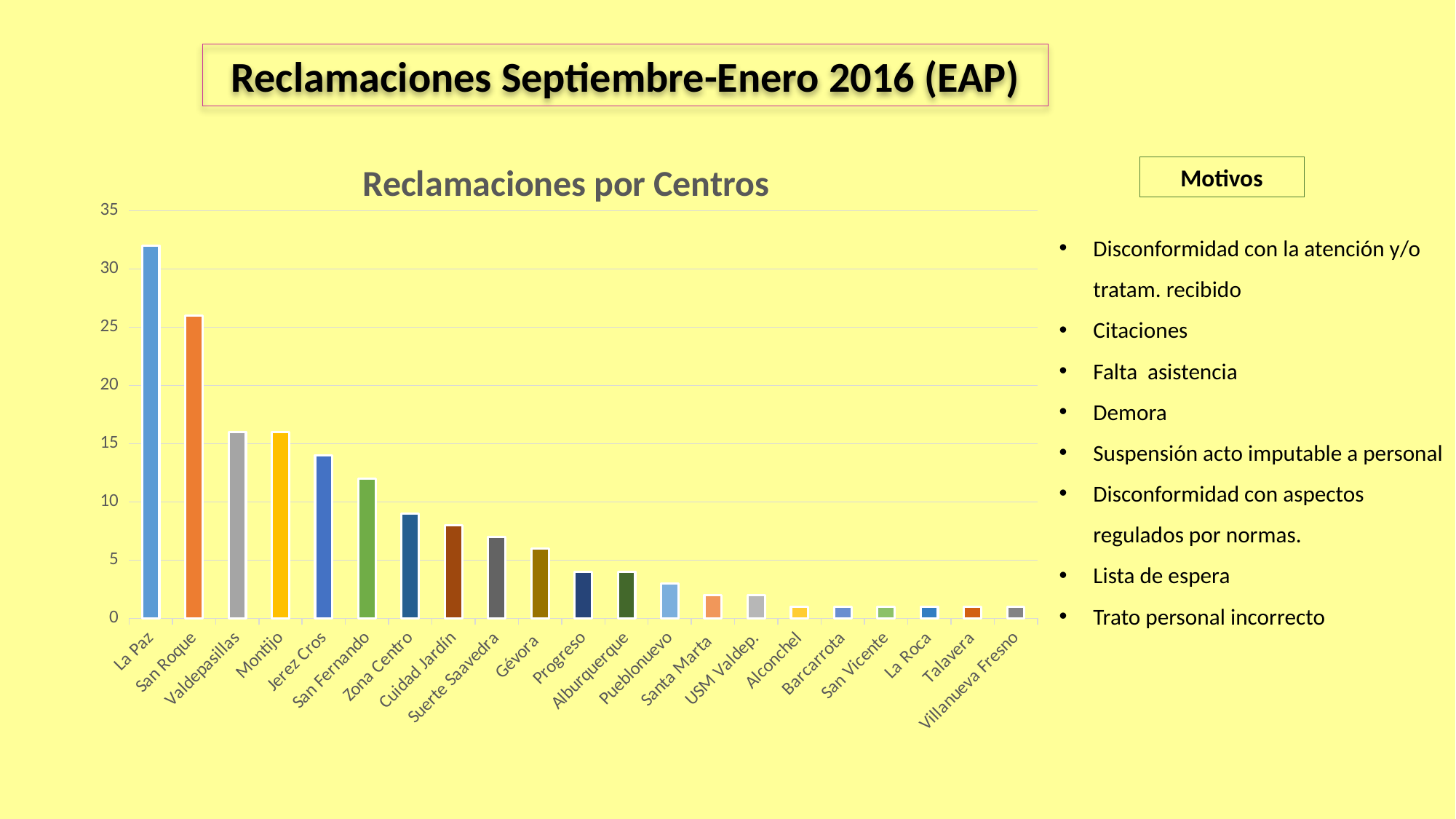
Which has more reclamaciones, Gévora or Progreso? Gévora What kind of chart is shown on the slide? bar chart Do the values generally rise or fall from left to right along the x axis? fall Is the value for Zona Centro greater or less than 10? less Which has more reclamaciones, Jerez Cros or Zona Centro? Jerez Cros Is the value for Valdepasillas greater or less than 20? less Is the value for San Fernando greater or less than 10? greater Which centre has the highest number of reclamaciones in the chart? La Paz How many centres are shown on the x axis of the chart? 21 Which has more reclamaciones, La Paz or San Roque? La Paz